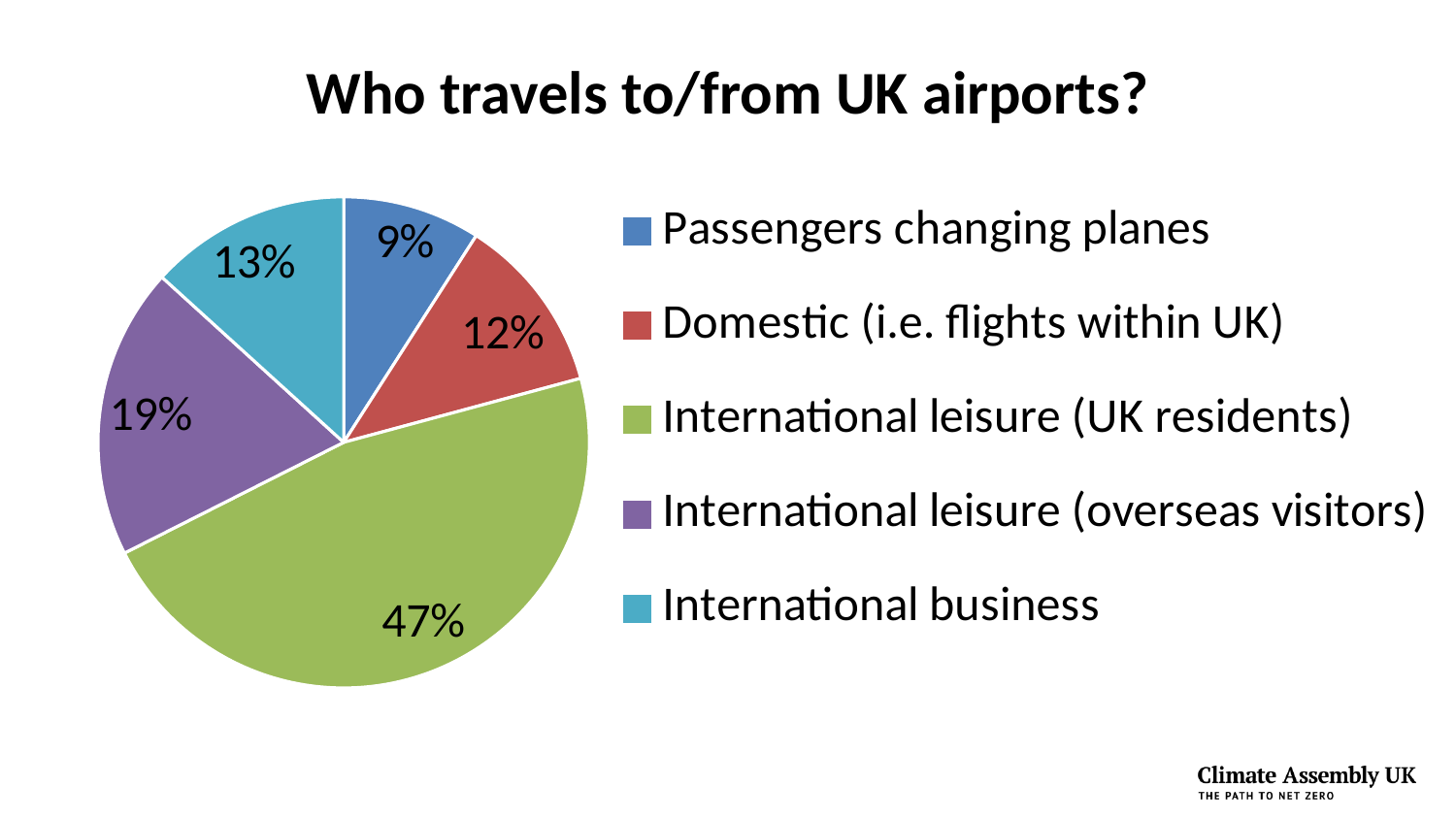
How many categories does the pie chart show? 5 What is the difference in percentage points between International leisure (UK residents) and International leisure (overseas visitors)? 28 What share of travellers is Domestic (i.e. flights within UK)? 12% What share of travellers is International business? 13% What share of travellers is Passengers changing planes? 9% What is the title of the slide? Who travels to/from UK airports? Which is larger: International business or Domestic (i.e. flights within UK)? International business What share of travellers is International leisure (overseas visitors)? 19% What share of travellers is International leisure (UK residents)? 47% Which category has the largest slice of the pie? International leisure (UK residents) Which category has the smallest slice of the pie? Passengers changing planes What kind of chart is shown on the slide? Pie chart